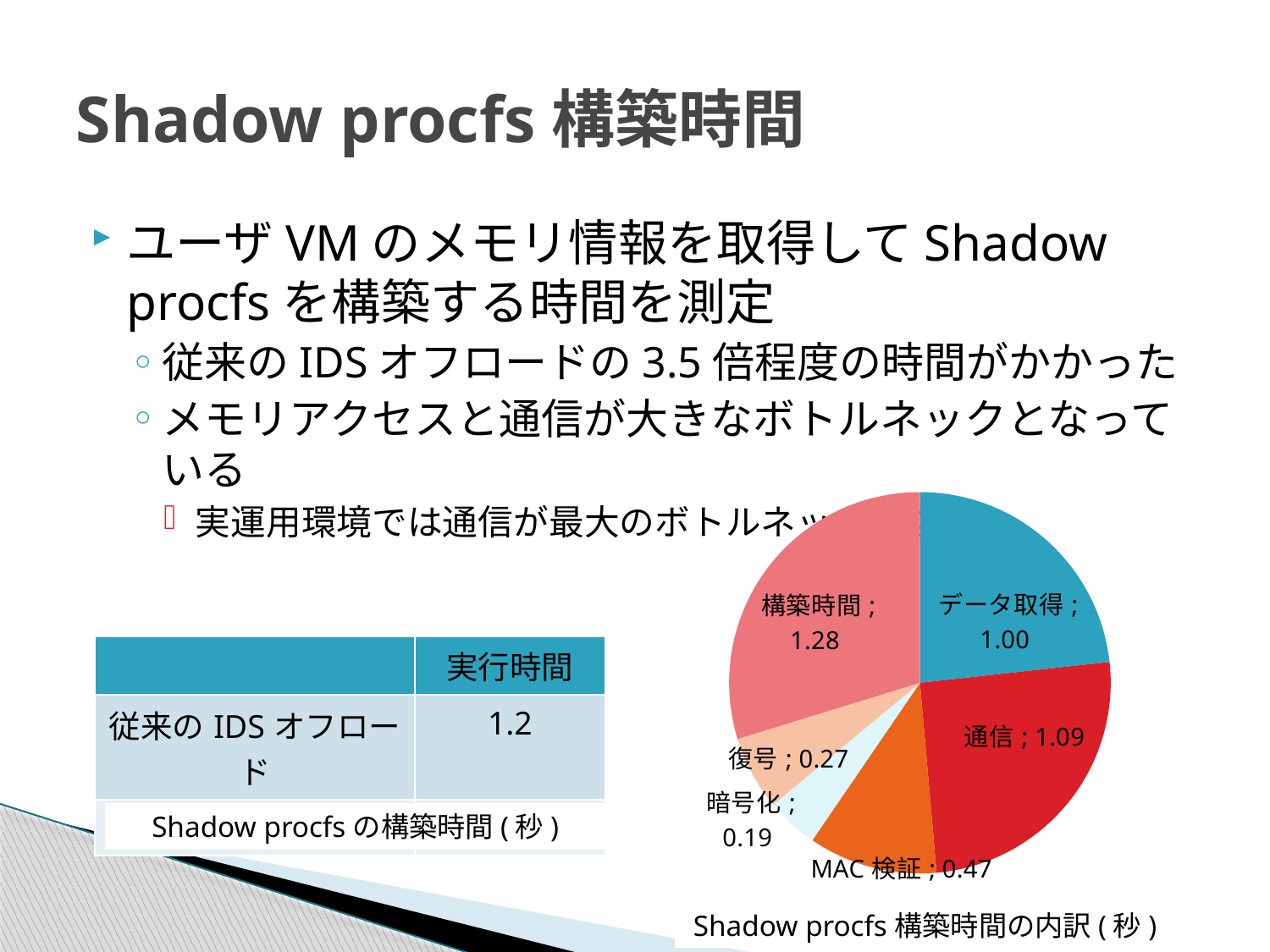
What is the value for 通信 in the pie chart? 1.09 What is the title of the pie chart? Shadow procfs 構築時間の内訳 ( 秒 ) What is the value for MAC 検証 in the pie chart? 0.47 How many slices does the pie chart have? 6 What is the difference between the values for 構築時間 and 通信 in the pie chart? 0.19 What kind of chart is shown on the slide? pie chart What is the value for 復号 in the pie chart? 0.27 Which slice of the pie chart has the largest value? 構築時間 What is the value for 暗号化 in the pie chart? 0.19 Which slice of the pie chart has the smallest value? 暗号化 Which is larger in the pie chart, 復号 or 暗号化? 復号 What is the value for データ取得 in the pie chart? 1.00